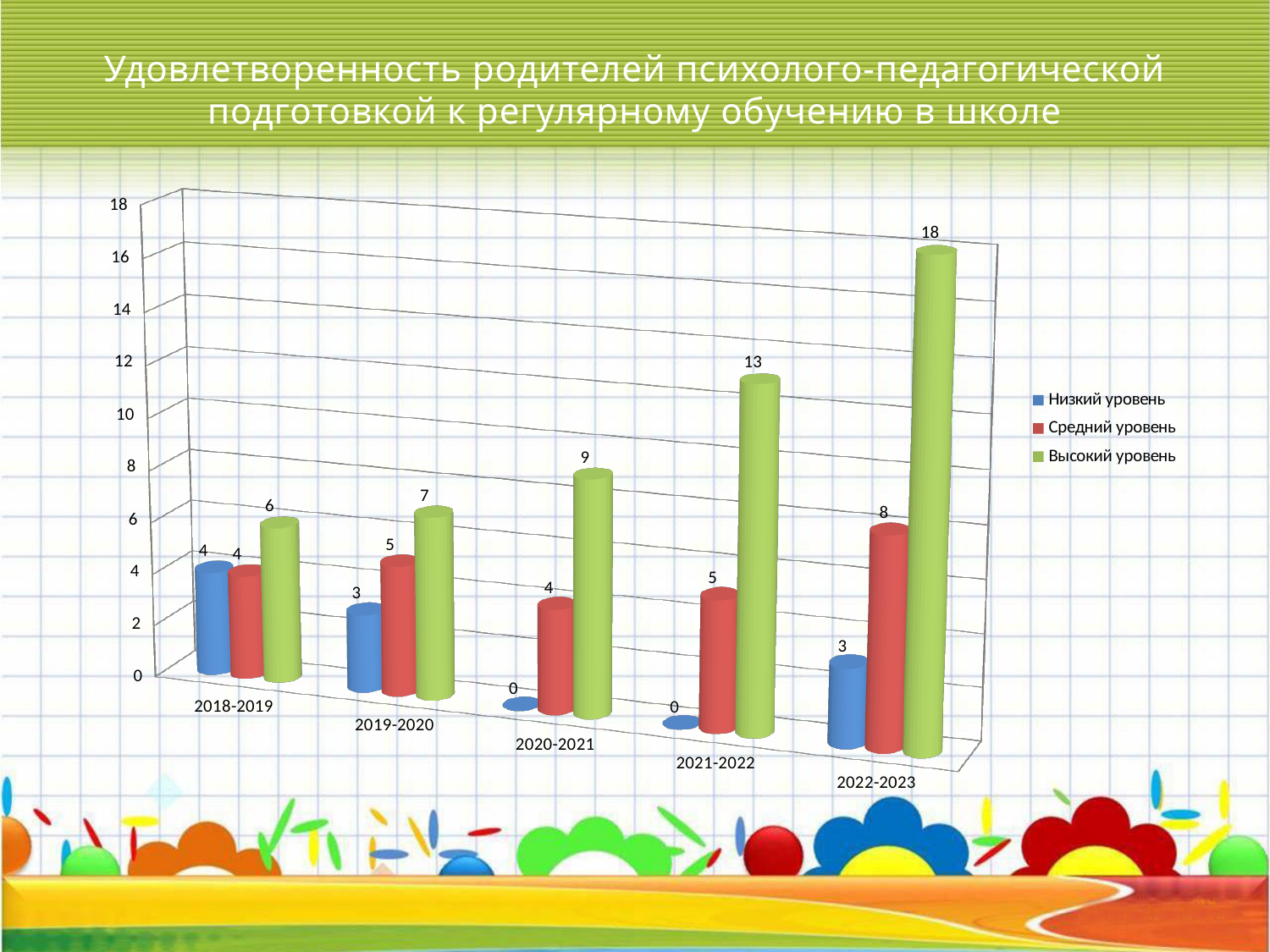
What is the value for Средний уровень in 2019-2020? 5 How many series does the legend list? 3 What kind of chart is shown on the slide? Bar chart Which is larger in 2022-2023: Средний уровень or Низкий уровень? Средний уровень In which period is the value for Высокий уровень the lowest? 2018-2019 What is the value for Низкий уровень in 2020-2021? 0 What is the value for Высокий уровень in 2022-2023? 18 What is the difference between Высокий уровень in 2022-2023 and in 2021-2022? 5 What is the total of the three series in 2022-2023? 29 Does the value for Высокий уровень rise or fall from 2018-2019 to 2022-2023? Rises How many periods (categories) are shown on the x axis? 5 In which period is the value for Высокий уровень the highest? 2022-2023